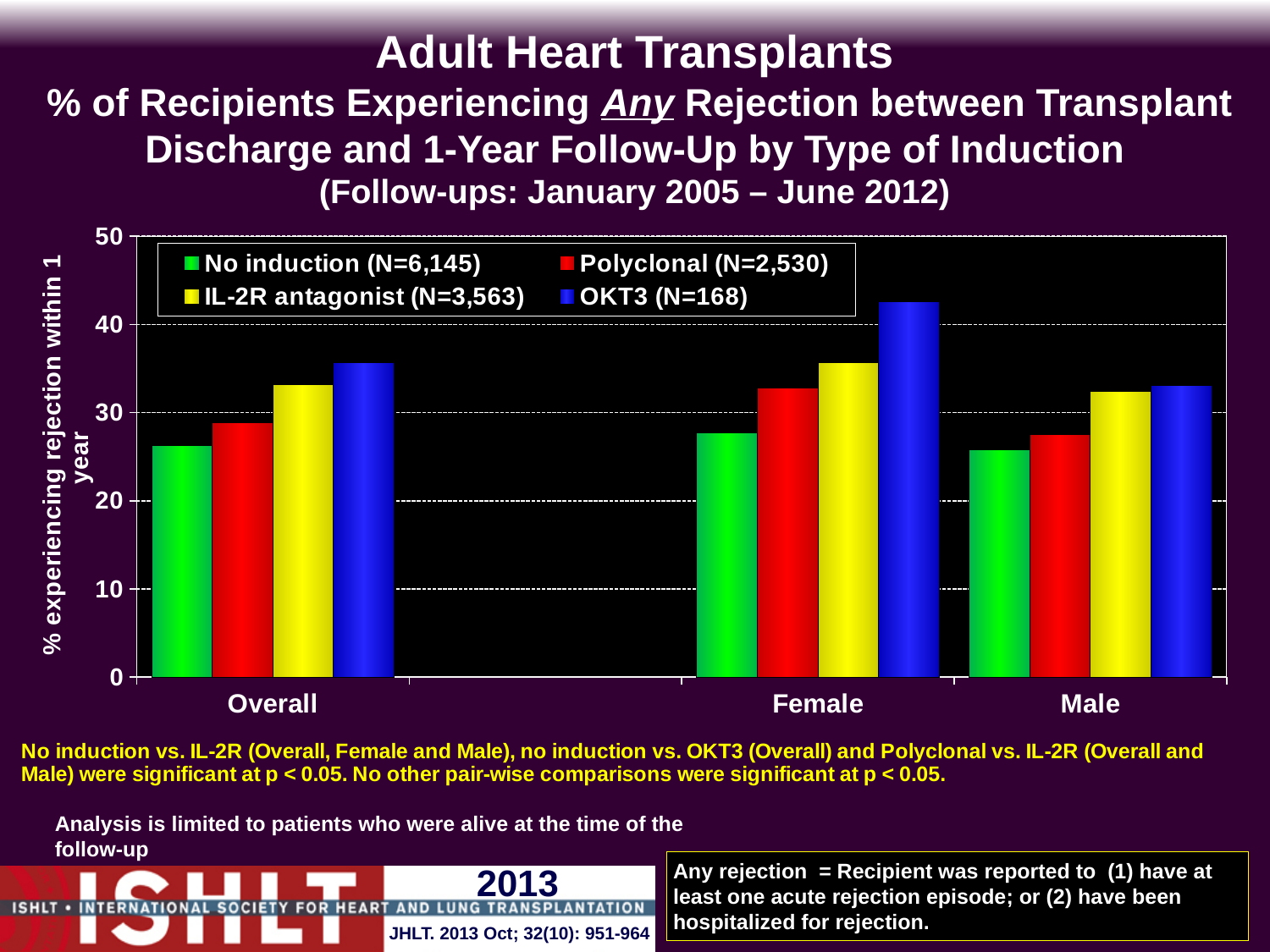
According to the legend, what is the N for the OKT3 series? 168 How many series does the legend list? 4 Which is larger: OKT3 in the Female group or OKT3 in the Male group? OKT3 in the Female group Is the value for No induction in the Overall group greater or less than 30? less What kind of chart is shown on the slide? bar chart Is the value for OKT3 in the Female group greater or less than 40? greater Which induction type has the lowest value in the Overall group? No induction Which induction type has the highest value in the Female group? OKT3 In the Overall group, which is larger: IL-2R antagonist or Polyclonal? IL-2R antagonist Is the value for IL-2R antagonist in the Male group greater or less than 30? greater How many categories are shown on the x axis? 3 Which bar is the highest on the whole chart? OKT3 in the Female group